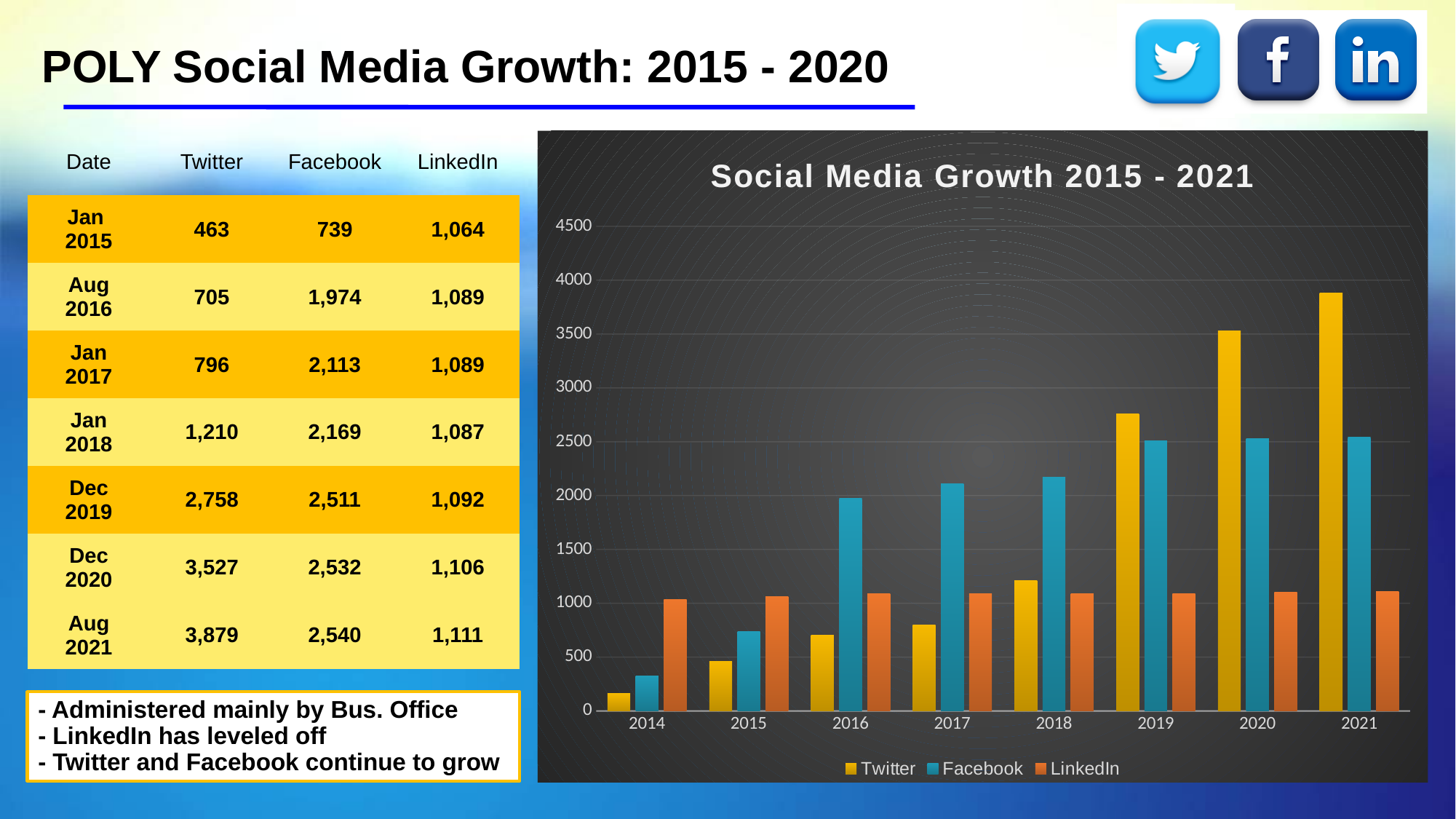
What kind of chart is shown on the slide? bar chart Do the Twitter values rise or fall from 2014 to 2021? rise In which year is the Twitter bar highest? 2021 In which year is the Twitter bar lowest? 2014 Is the Facebook value for 2016 greater or less than 1500? greater How many years are shown along the x axis of the chart? 8 In 2015, which is larger: the Facebook bar or the LinkedIn bar? LinkedIn How many series does the legend of the chart list? 3 Is the LinkedIn value for 2018 greater or less than 1500? less Is the Twitter value for 2020 greater or less than 3000? greater Which series has the tallest bar in 2014? LinkedIn What is the title of the chart? Social Media Growth 2015 - 2021